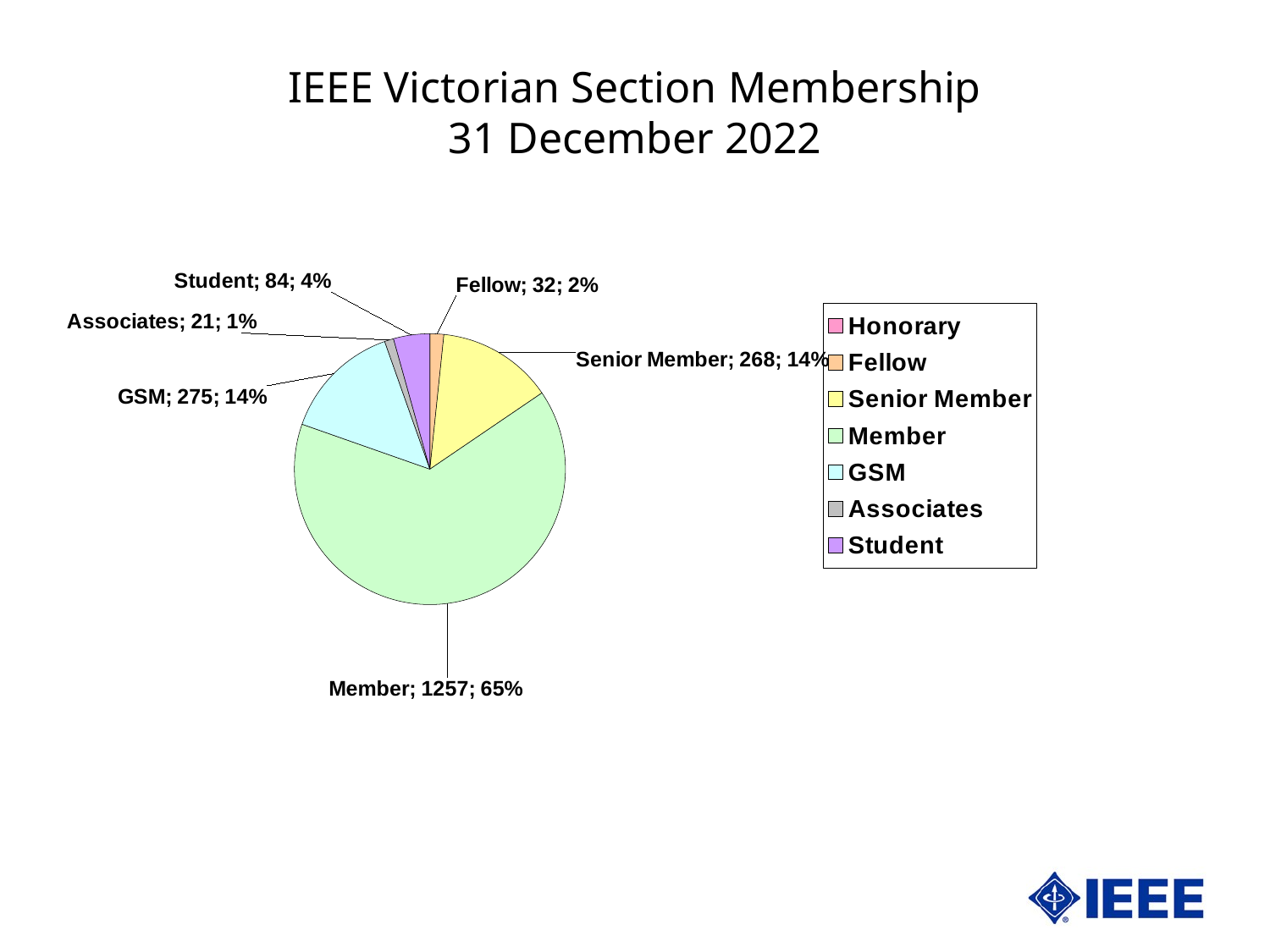
Which labelled category has the smallest value? Associates How many entries does the legend list? 7 What share of the pie does the Member slice represent? 65% What share of the pie does the Associates slice represent? 1% What is the value shown for GSM? 275 What is the difference between the Member value and the GSM value? 982 Which has a larger value, GSM or Senior Member? GSM How many members are in the Member category? 1257 Which category has the largest slice of the pie? Member What is the value shown for Fellow? 32 What kind of chart is shown on the slide? Pie chart What is the difference between the Student value and the Fellow value? 52